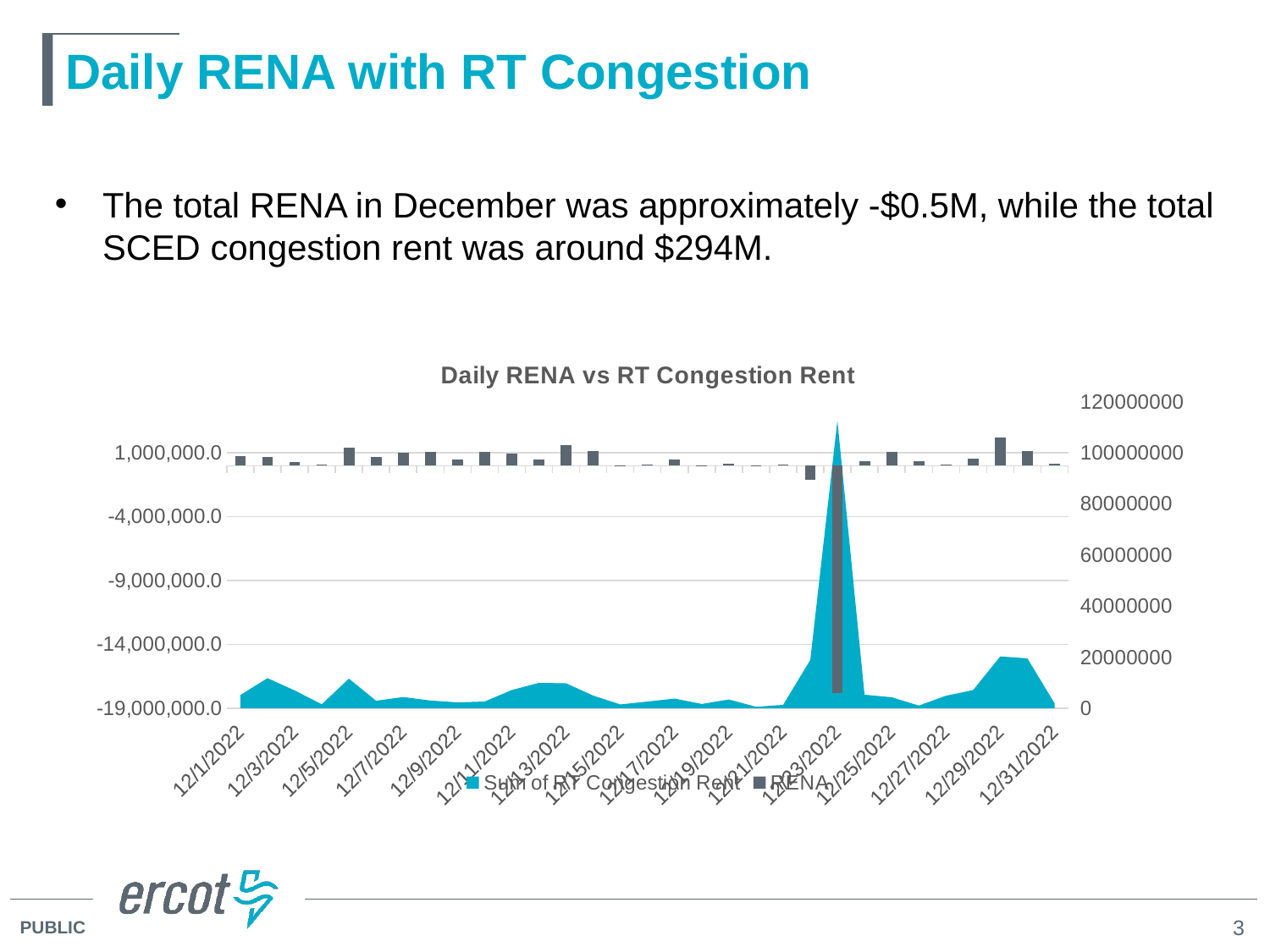
On which date is the RENA value lowest? 12/23/2022 How many date labels are shown on the x axis? 16 What is the title of the chart? Daily RENA vs RT Congestion Rent On which date does the Sum of RT Congestion Rent reach its highest value? 12/23/2022 What are the two series named in the legend? Sum of RT Congestion Rent and RENA Is the peak value of Sum of RT Congestion Rent on 12/23/2022 greater or less than 100000000? greater Is the RENA value on 12/23/2022 greater or less than -14,000,000.0? less Does the Sum of RT Congestion Rent rise or fall from 12/23/2022 to 12/25/2022? fall Which date has a larger Sum of RT Congestion Rent, 12/23/2022 or 12/29/2022? 12/23/2022 How many series does the chart legend list? 2 What kind of chart is shown on the slide? Combined area and bar chart Which date has a larger RENA value, 12/23/2022 or 12/29/2022? 12/29/2022